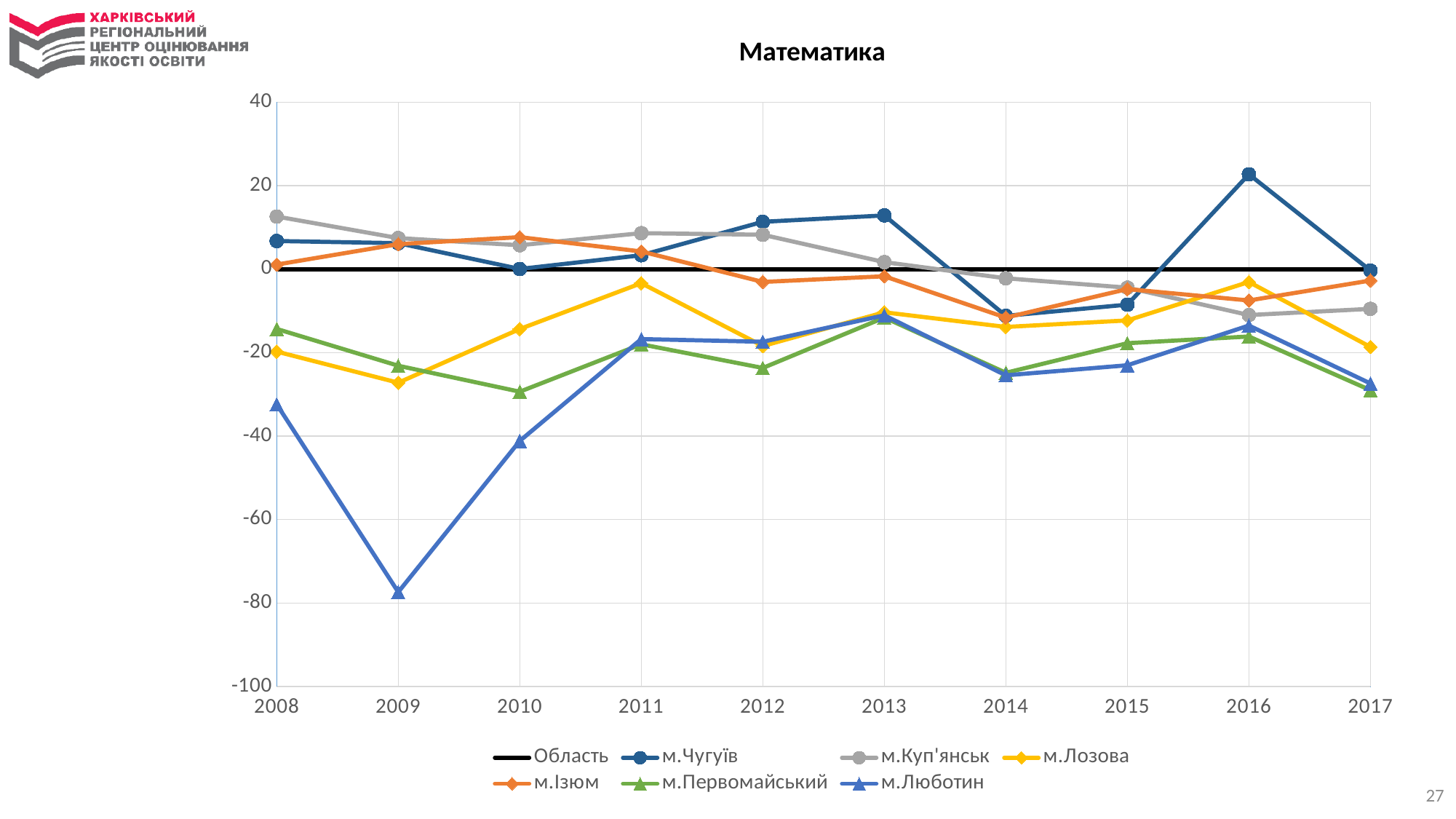
How many series does the legend list? 7 In which year does м.Люботин reach its lowest value? 2009 Is the value for м.Лозова in 2009 greater or less than -20? less Which series has the lowest value in 2008? м.Люботин What is the title of the chart? Математика How many years are plotted along the x axis? 10 Is the value for м.Первомайський in 2010 greater or less than -20? less Is the value for м.Люботин in 2009 greater or less than -60? less In which year does м.Чугуїв reach its highest value? 2016 In 2008, which is larger: the value for м.Куп'янськ or for м.Чугуїв? м.Куп'янськ What kind of chart is shown on the slide? line chart